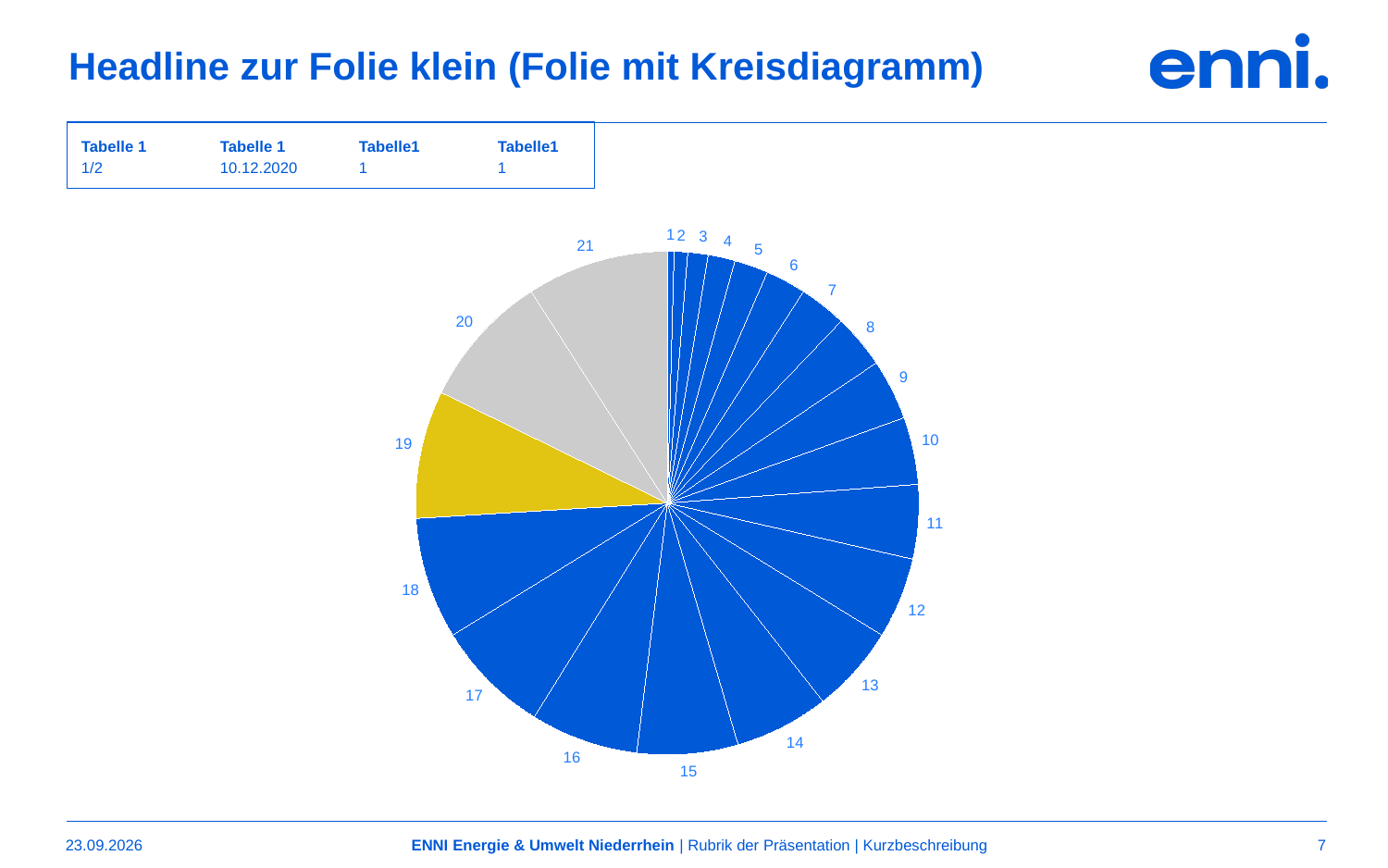
Which slices of the pie chart are coloured grey? 20 and 21 What kind of chart is shown on the slide? pie chart Which slice is larger in the pie chart, slice 5 or slice 17? 17 How many slices does the pie chart have? 21 Which slice is larger in the pie chart, slice 3 or slice 19? 19 Which slice is larger in the pie chart, slice 18 or slice 2? 18 Which slice of the pie chart is the smallest? 1 Which slice of the pie chart is coloured yellow? 19